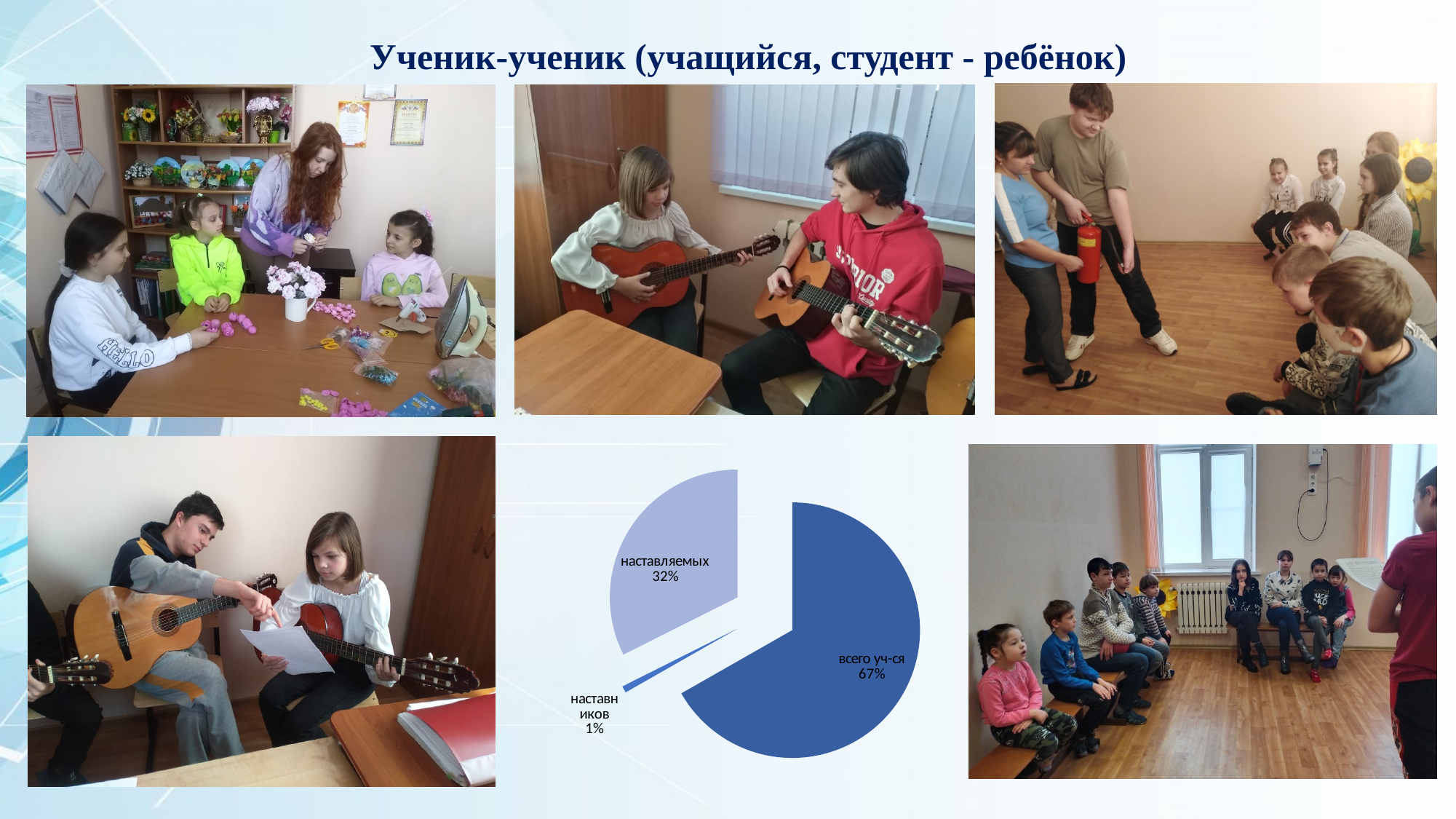
How many slices does the pie chart have? 3 What kind of chart is shown on the slide? pie chart Which is larger: the "наставляемых" slice or the "наставников" slice? наставляемых Which slice of the pie chart is the largest? всего уч-ся Which slice of the pie chart is the smallest? наставников What is the difference in percentage points between the "наставляемых" slice and the "наставников" slice? 31 Which slice of the pie chart is drawn in the darkest blue? всего уч-ся What is the difference in percentage points between the "всего уч-ся" slice and the "наставляемых" slice? 35 What share of the pie does the slice "наставников" represent? 1% What share of the pie does the slice "наставляемых" represent? 32% What share of the pie does the slice "всего уч-ся" represent? 67%